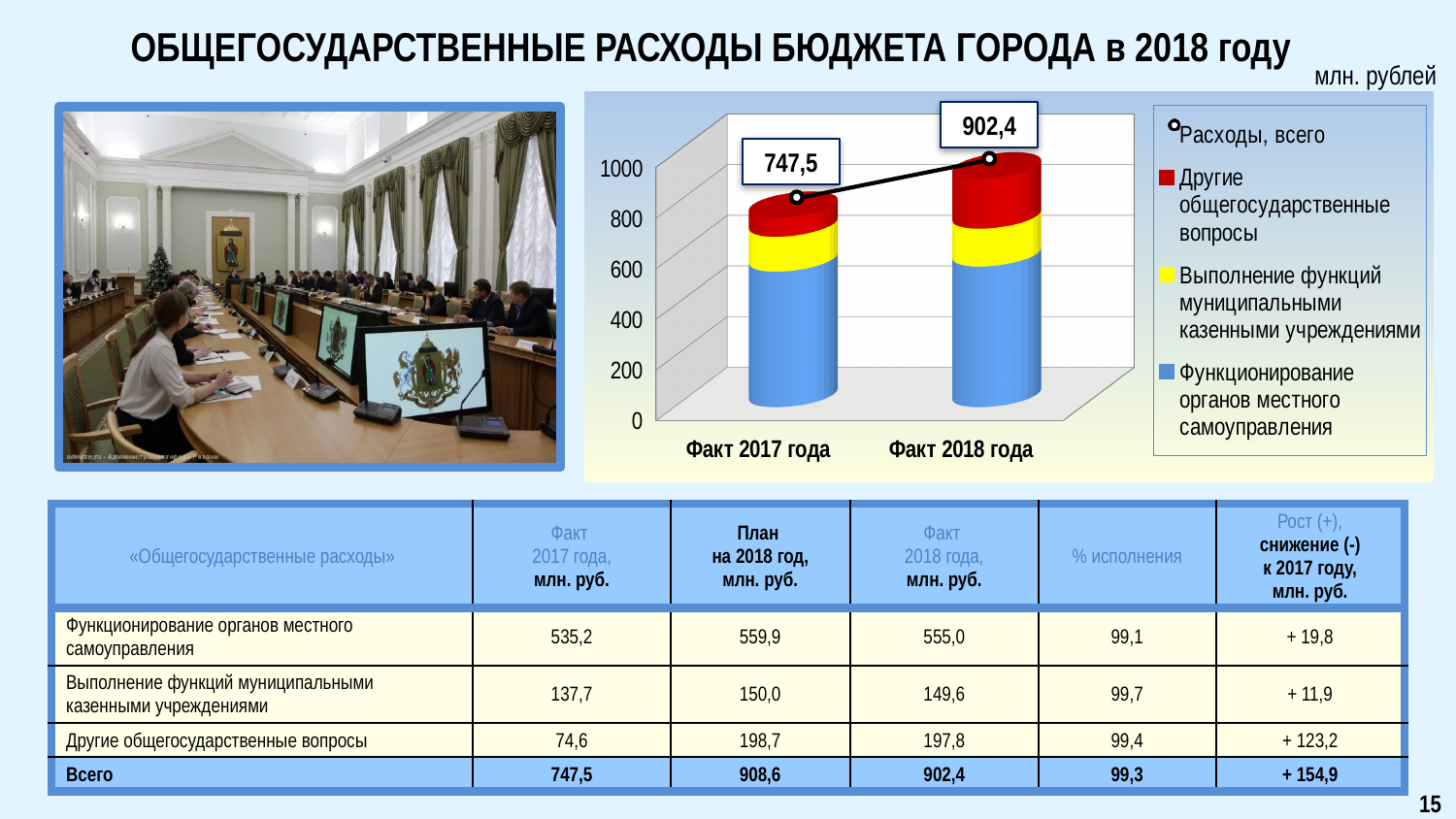
What is the value of «Расходы, всего» for Факт 2017 года? 747,5 How many categories are shown on the x axis of the chart? 2 By how much does «Расходы, всего» for Факт 2018 года exceed that for Факт 2017 года? 154,9 Which category has the highest value of «Расходы, всего»? Факт 2018 года Is the blue segment (Функционирование органов местного самоуправления) for Факт 2017 года greater or less than 400? greater Is the value of «Расходы, всего» for Факт 2017 года greater or less than 800? less What is the value of «Расходы, всего» for Факт 2018 года? 902,4 Do total expenditures rise or fall from Факт 2017 года to Факт 2018 года? rise How many entries does the chart legend list? 4 Which category has the higher total expenditure, Факт 2017 года or Факт 2018 года? Факт 2018 года What kind of chart is shown on the slide? bar chart What colour represents «Другие общегосударственные вопросы» in the chart? red